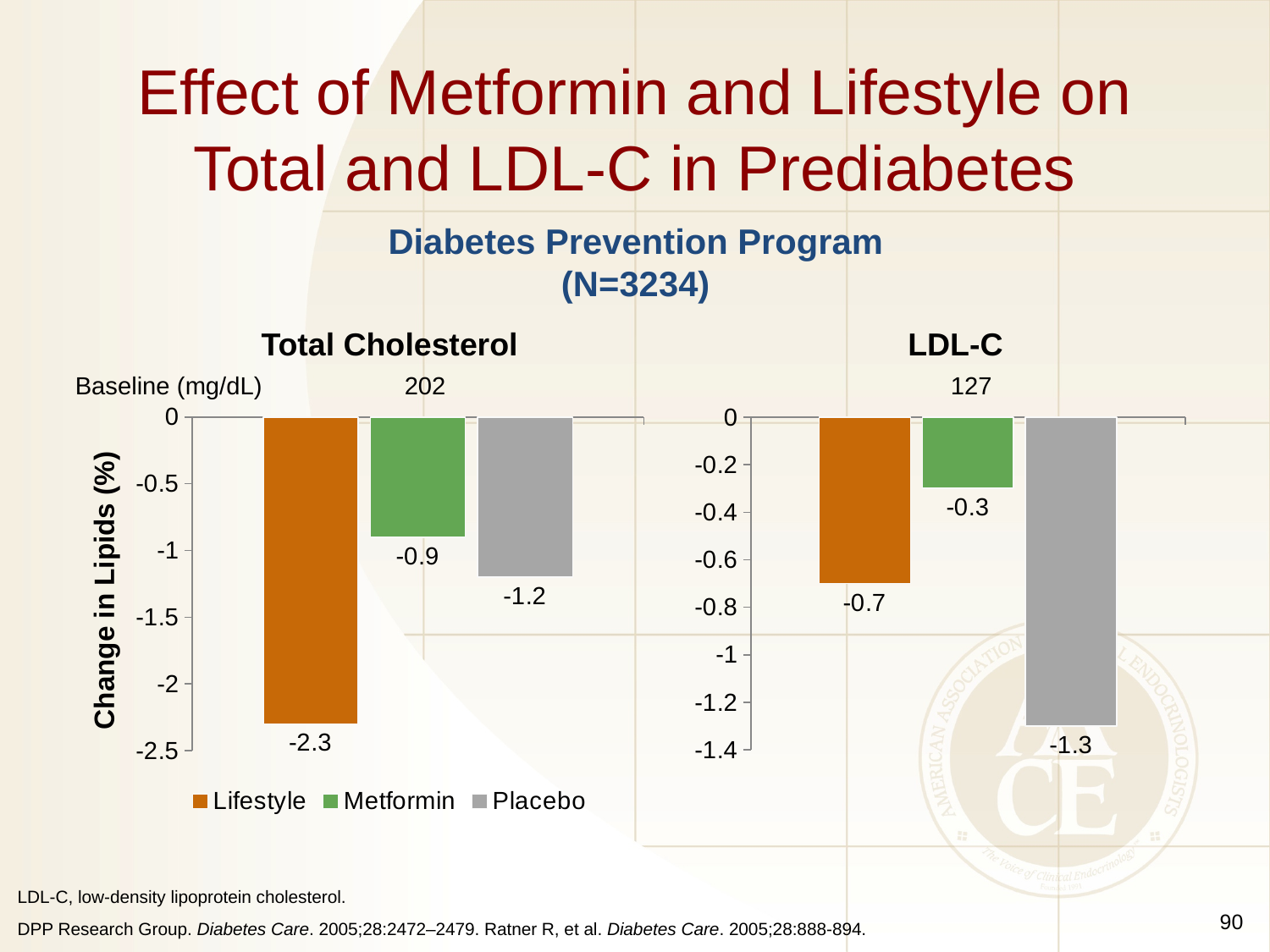
What kind of chart is used to show the change in lipids? Bar chart What is the baseline value (mg/dL) shown for the LDL-C chart? 127 How many series does the legend list? 3 In the LDL-C chart, what is the change in lipids for Lifestyle? -0.7 In the LDL-C chart, which group has a larger decrease in lipids, Lifestyle or Placebo? Placebo In the Total Cholesterol chart, what is the change in lipids for Lifestyle? -2.3 In the LDL-C chart, which group shows the smallest decrease in lipids? Metformin In the LDL-C chart, what is the change in lipids for Placebo? -1.3 In the Total Cholesterol chart, what is the change in lipids for Metformin? -0.9 In the Total Cholesterol chart, which group shows the largest decrease in lipids? Lifestyle Which colour represents Metformin in the charts? Green In the Total Cholesterol chart, what is the difference between the Lifestyle and Placebo values? 1.1